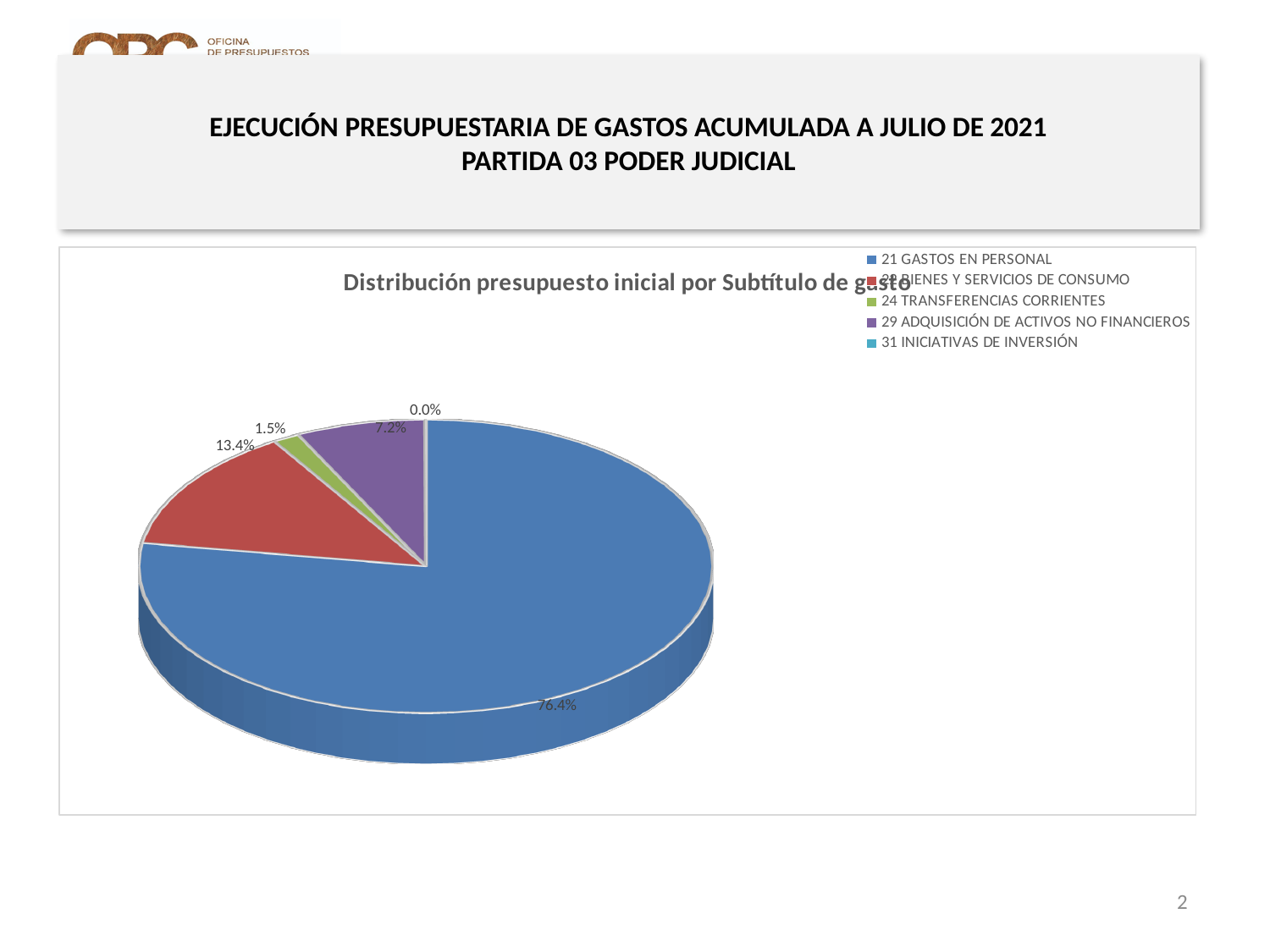
What is the difference in percentage points between 21 GASTOS EN PERSONAL and 29 ADQUISICIÓN DE ACTIVOS NO FINANCIEROS? 69.2 percentage points What kind of chart is shown on the slide? Pie chart How many categories does the legend list? 5 Which category has the largest slice of the pie? 21 GASTOS EN PERSONAL What percentage is shown for 24 TRANSFERENCIAS CORRIENTES? 1.5% What is the title of the chart? Distribución presupuesto inicial por Subtítulo de gasto What colour is the slice for 21 GASTOS EN PERSONAL? Blue What share of the pie does 21 GASTOS EN PERSONAL represent? 76.4% Which category has the smallest slice of the pie? 31 INICIATIVAS DE INVERSIÓN Which is larger, the share for 29 ADQUISICIÓN DE ACTIVOS NO FINANCIEROS or the share for 24 TRANSFERENCIAS CORRIENTES? 29 ADQUISICIÓN DE ACTIVOS NO FINANCIEROS What percentage is shown for 31 INICIATIVAS DE INVERSIÓN? 0.0% What percentage is shown for 29 ADQUISICIÓN DE ACTIVOS NO FINANCIEROS? 7.2%